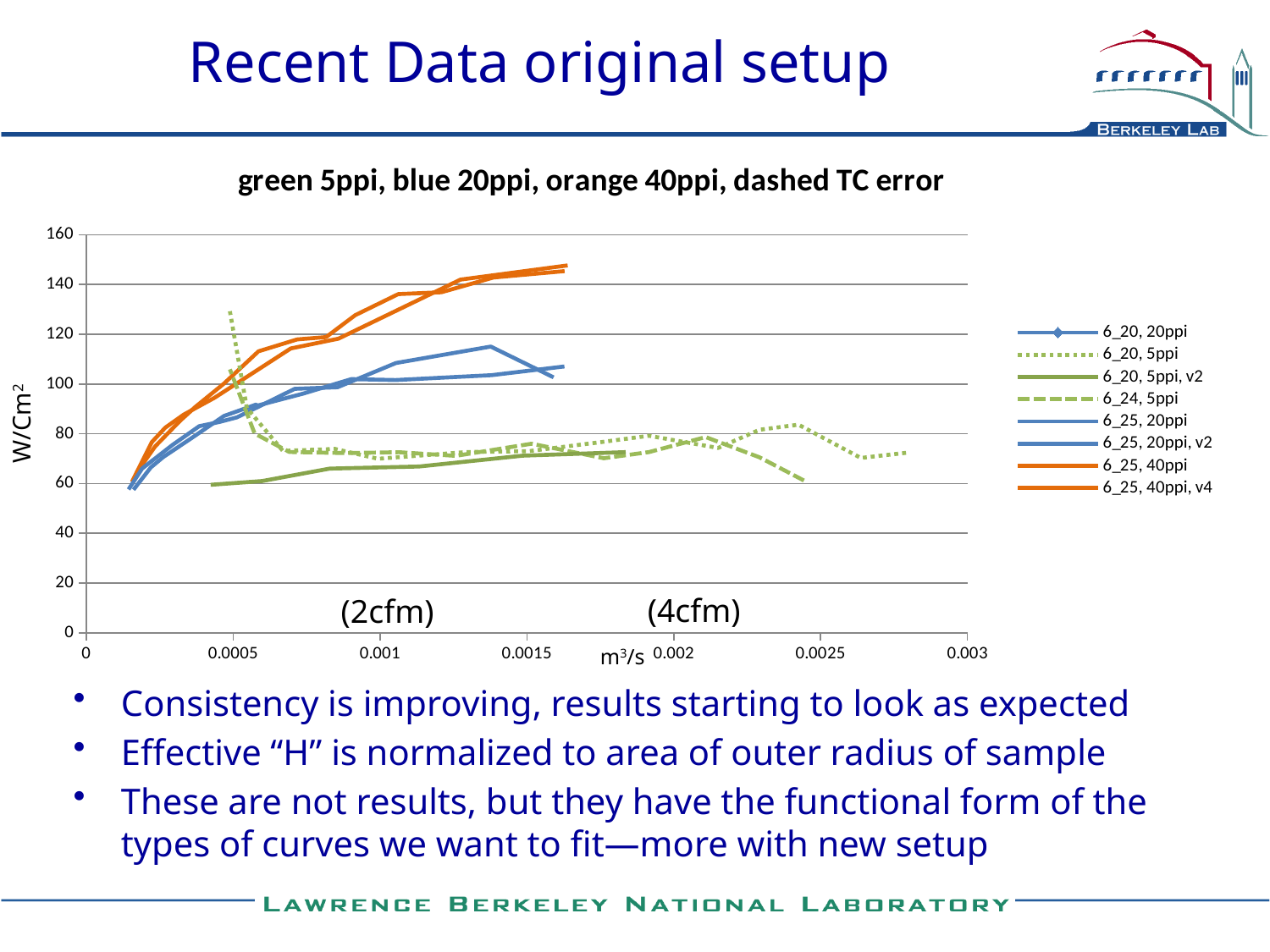
Is the value of the 6_24, 5ppi series at its right-hand end (near 0.0024 m³/s) greater or less than 80? less What kind of chart is shown on the slide? line chart What is the title of the chart? green 5ppi, blue 20ppi, orange 40ppi, dashed TC error Do the values of the 6_25, 40ppi series rise or fall as the flow rate on the x axis increases? rise How many series does the chart legend list? 8 Is the highest value reached by the 6_25, 20ppi series greater or less than 100? greater Is the highest value reached by the 6_25, 40ppi series greater or less than 140? greater What is the label on the vertical axis of the chart? W/Cm² At 0.001 m³/s, which is higher: the 6_25, 40ppi series or the 6_25, 20ppi series? 6_25, 40ppi Which colour of lines reaches the highest values on the chart? orange